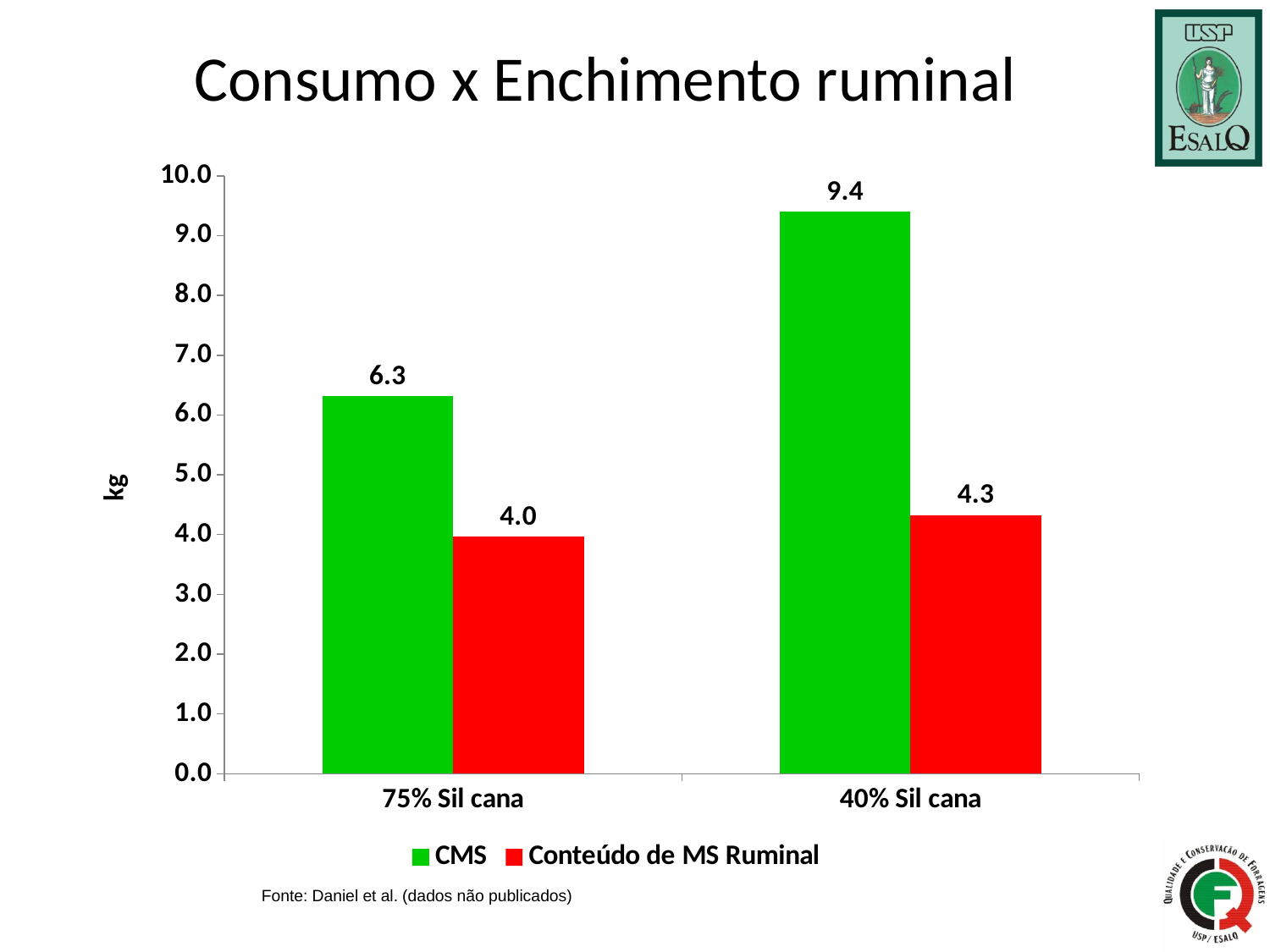
What is the Conteúdo de MS Ruminal value for 75% Sil cana? 4.0 What is the difference between the CMS values for 40% Sil cana and 75% Sil cana? 3.1 Which is larger for 40% Sil cana: CMS or Conteúdo de MS Ruminal? CMS What is the label of the y axis? kg How many categories are shown on the x axis? 2 Is the CMS value for 40% Sil cana greater or less than 9.0? greater What is the Conteúdo de MS Ruminal value for 40% Sil cana? 4.3 What kind of chart is shown on the slide? bar chart What is the CMS value for 75% Sil cana? 6.3 Which category has the highest CMS value? 40% Sil cana How many series does the legend list? 2 Which category has the lowest Conteúdo de MS Ruminal value? 75% Sil cana